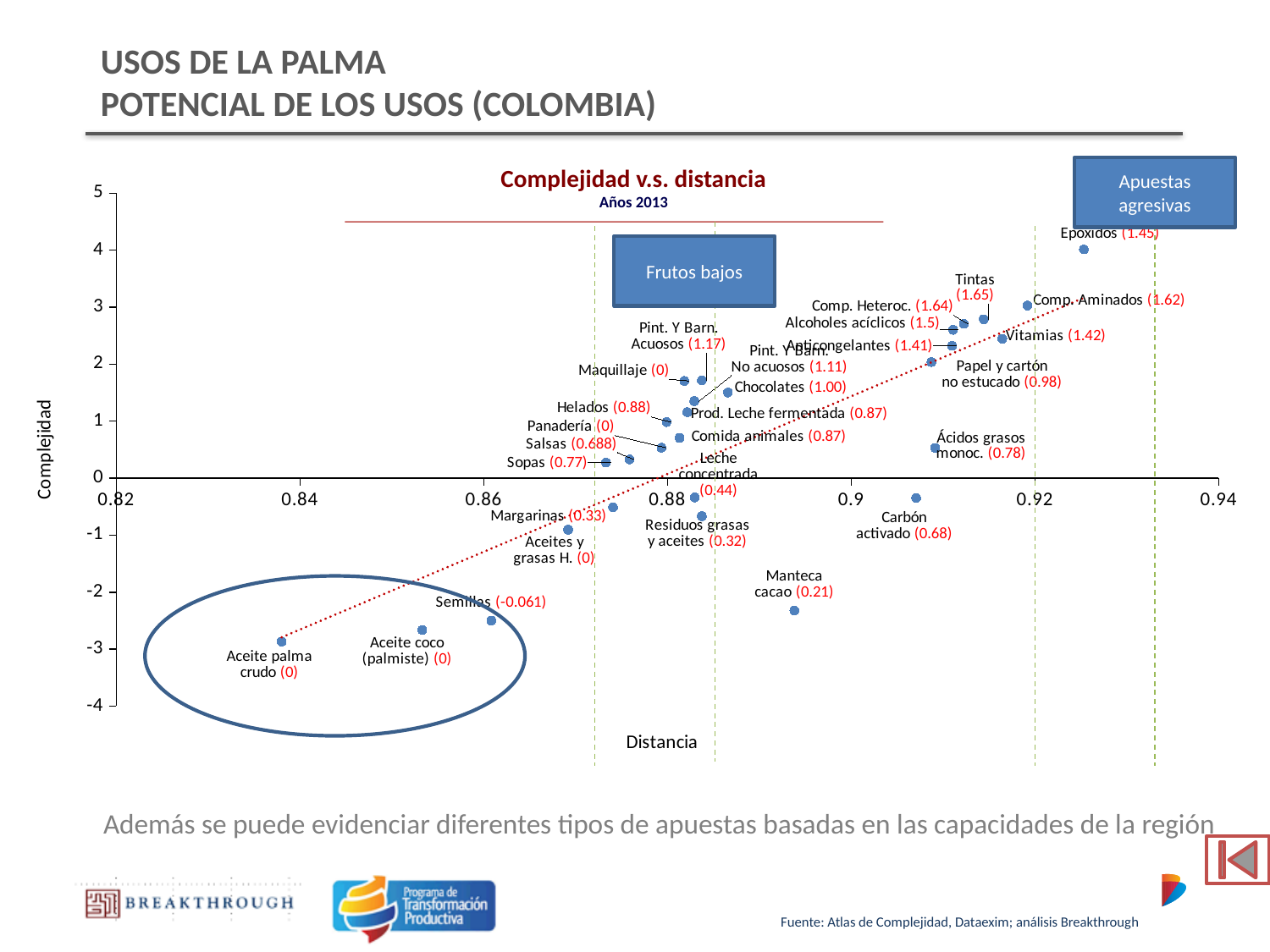
What value is printed in parentheses next to the Manteca cacao label? 0.21 Is the complejidad value for Aceite palma crudo greater or less than -2? less Is the distancia value for Epóxidos greater or less than 0.92? greater Which has a higher complejidad value, Tintas or Helados? Tintas What label is shown on the vertical axis of the chart? Complejidad Which labeled point has the lowest complejidad value? Aceite palma crudo Do the complejidad values generally rise or fall as distancia increases along the x axis? rise What value is printed in parentheses next to the Epóxidos label? 1.45 Is the complejidad value for Epóxidos greater or less than 3? greater What is the title of the chart? Complejidad v.s. distancia Which labeled point has the highest complejidad value? Epóxidos What kind of chart is shown on the slide? scatter chart